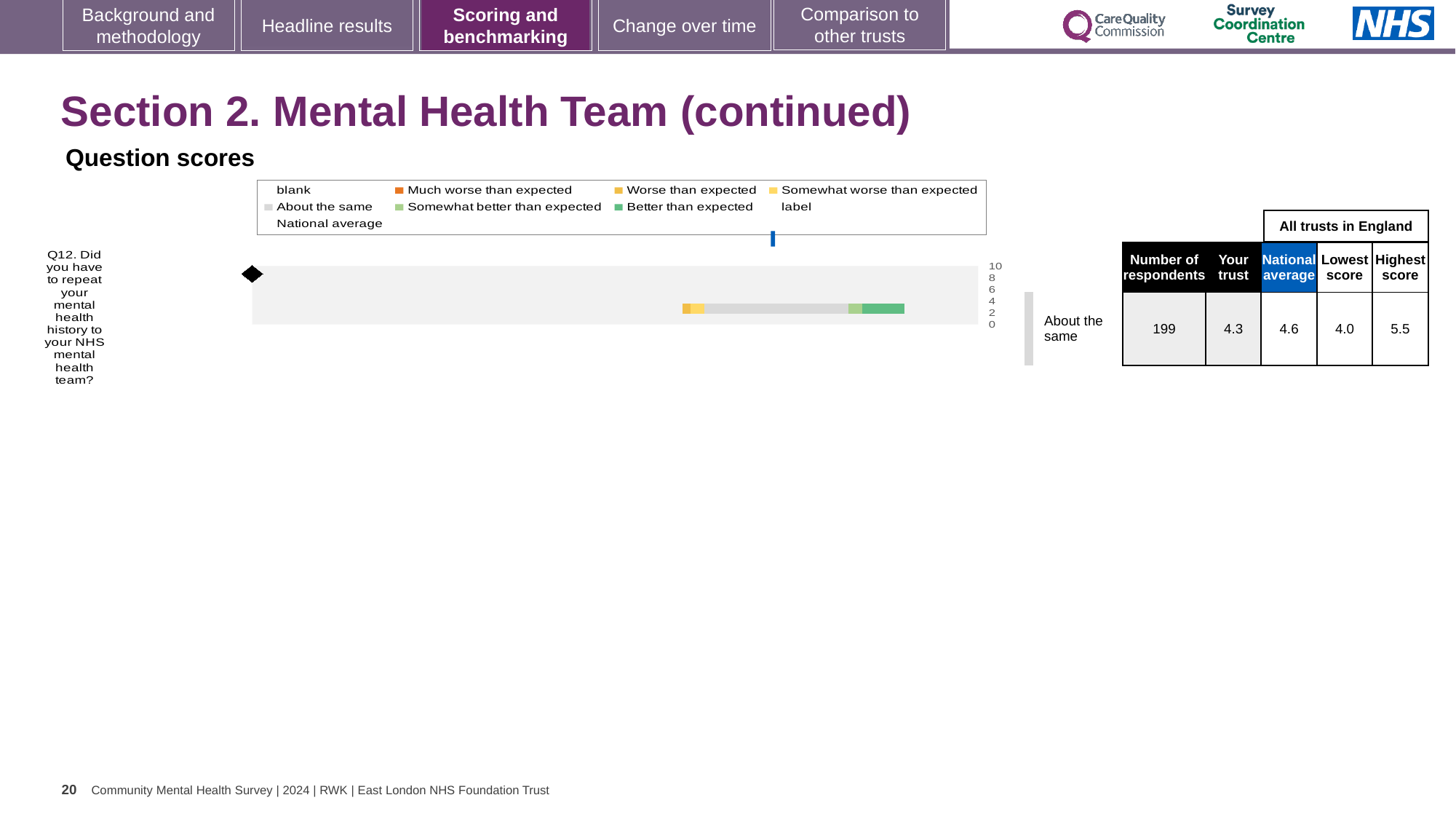
By how much does the national average exceed the 'Your trust' score for Q12? 0.3 What colour does the legend use for 'Better than expected'? Green What is the national average score shown for Q12? 4.6 What is the 'Your trust' score for Q12 (Did you have to repeat your mental health history to your NHS mental health team?)? 4.3 What kind of chart is shown on this slide? Bar chart How many respondents answered Q12? 199 What is the highest score across all trusts in England for Q12? 5.5 For Q12, which is larger: the 'Your trust' score or the national average? National average Which benchmark category is Q12 assigned to on this slide? About the same How many survey questions are plotted on the chart on this slide? 1 What is the difference between the highest score and the lowest score for Q12? 1.5 What is the lowest score across all trusts in England for Q12? 4.0